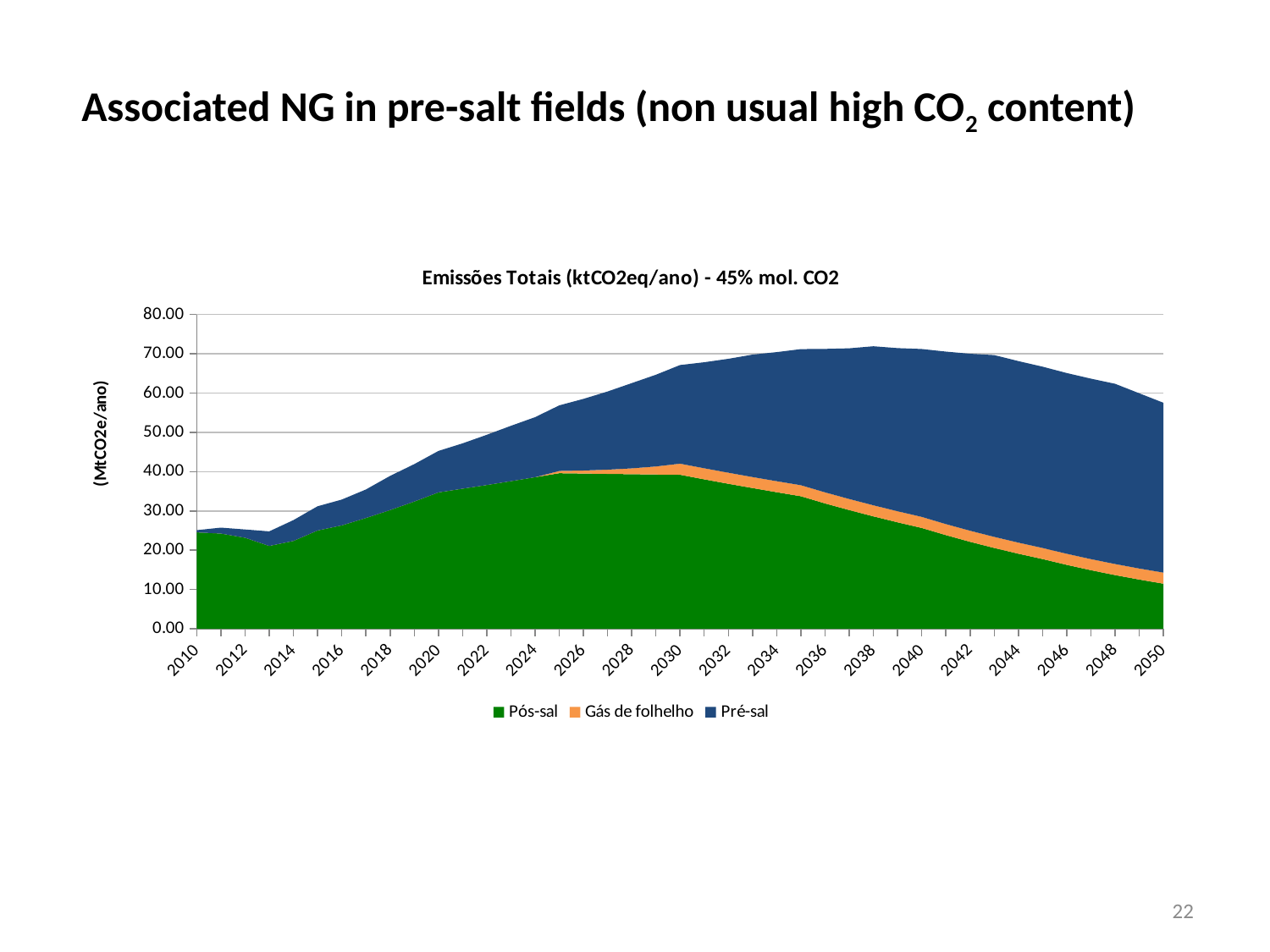
How many year labels are shown along the x axis? 21 Is the total stacked value in 2038 greater or less than 70.00? greater What is the label on the vertical axis of the chart? (MtCO2e/ano) Is the total stacked value in 2010 greater or less than 30.00? less Does the Pós-sal series rise or fall between 2026 and 2050? fall What kind of chart is shown on the slide? Stacked area chart In 2050, which series contributes the largest share of the stacked total? Pré-sal Is the value for Pós-sal in 2050 greater or less than 20.00? less How many series does the legend list? 3 What is the title of the chart? Emissões Totais (ktCO2eq/ano) - 45% mol. CO2 Does the total stacked value rise or fall between 2014 and 2038? rise